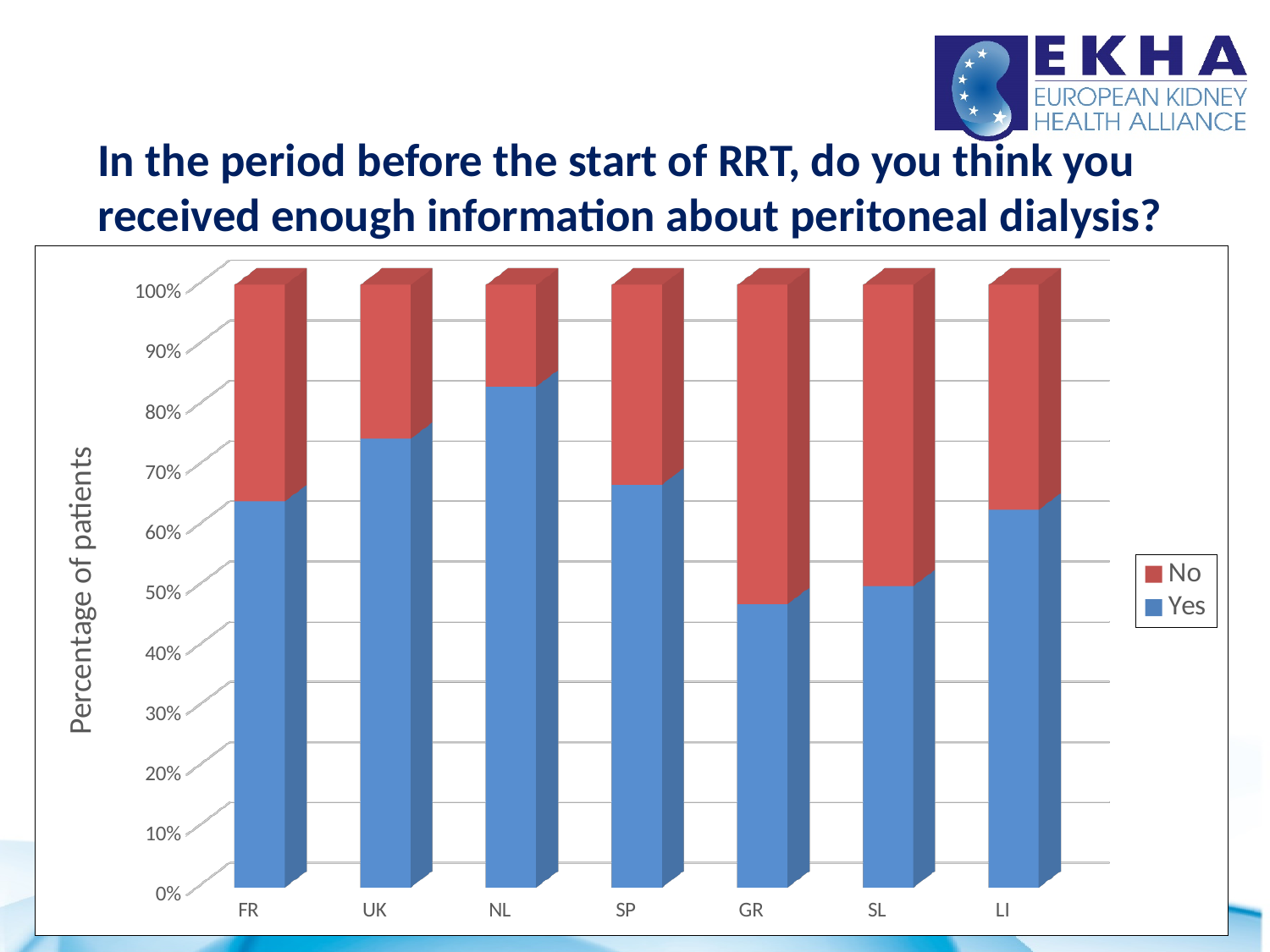
What colour represents the 'No' series in the chart? Red Which has a larger 'Yes' share, UK or SP? UK Is the 'Yes' share for NL greater or less than 70%? greater Is the 'Yes' share for GR greater or less than 60%? less Which country has the highest share of 'Yes' responses? NL Which country has the largest share of 'No' responses? GR How many countries are shown on the x axis of the chart? 7 Which country has the lowest share of 'Yes' responses? GR Is the 'Yes' share for FR greater or less than 50%? greater What kind of chart is shown on the slide? Stacked bar chart How many series does the legend list? 2 What is the label on the vertical axis of the chart? Percentage of patients